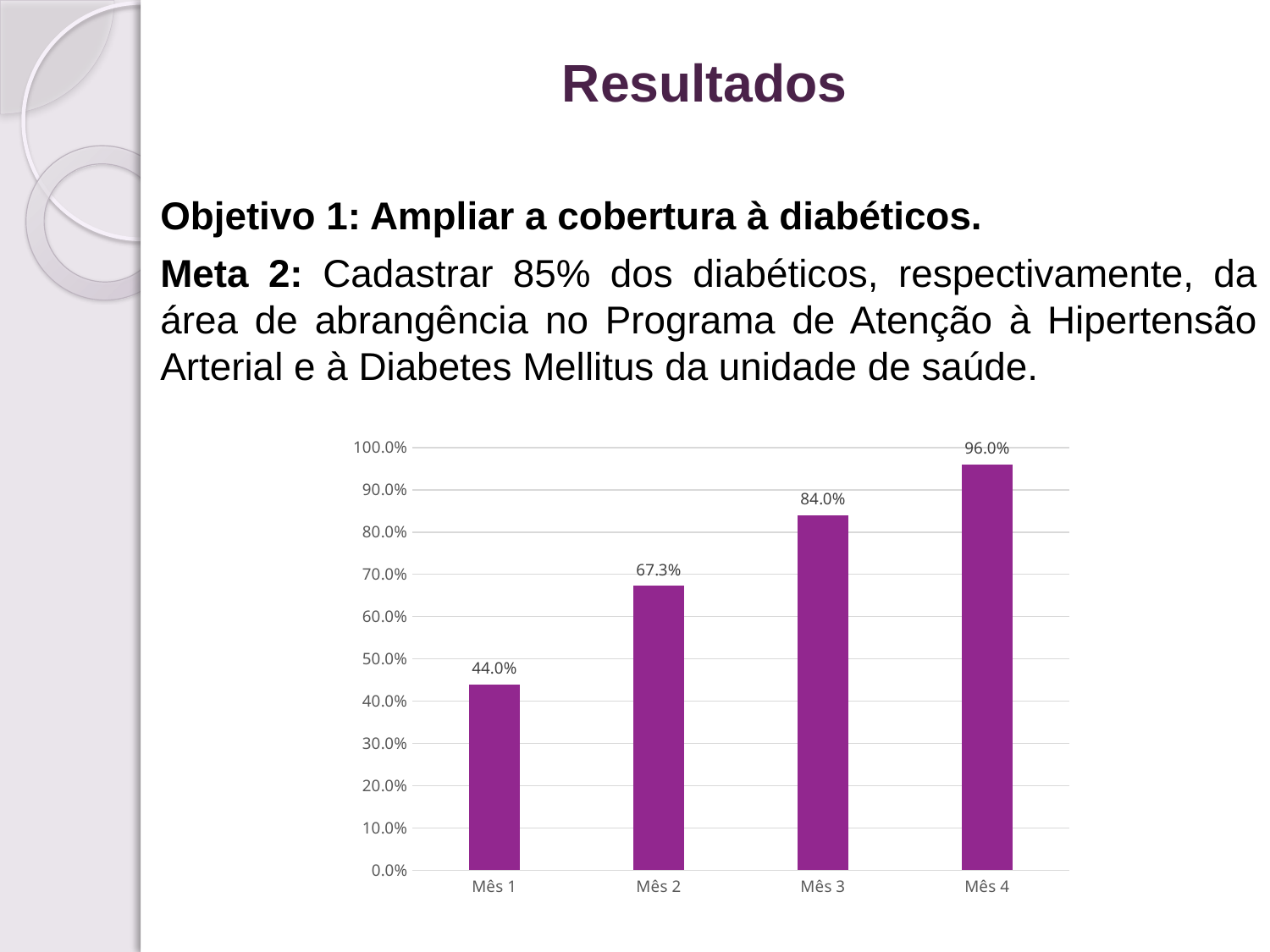
Which is larger, the value for Mês 2 or the value for Mês 3? Mês 3 What is the value for Mês 3? 84.0% What is the value for Mês 2? 67.3% Which month has the highest value? Mês 4 How many months are shown on the x axis? 4 Do the values rise or fall from Mês 1 to Mês 4? Rise What is the difference between the values for Mês 3 and Mês 2? 16.7% What is the value for Mês 1? 44.0% What is the difference between the values for Mês 4 and Mês 1? 52.0% Which month has the lowest value? Mês 1 What is the value for Mês 4? 96.0% What kind of chart is shown on the slide? Bar chart